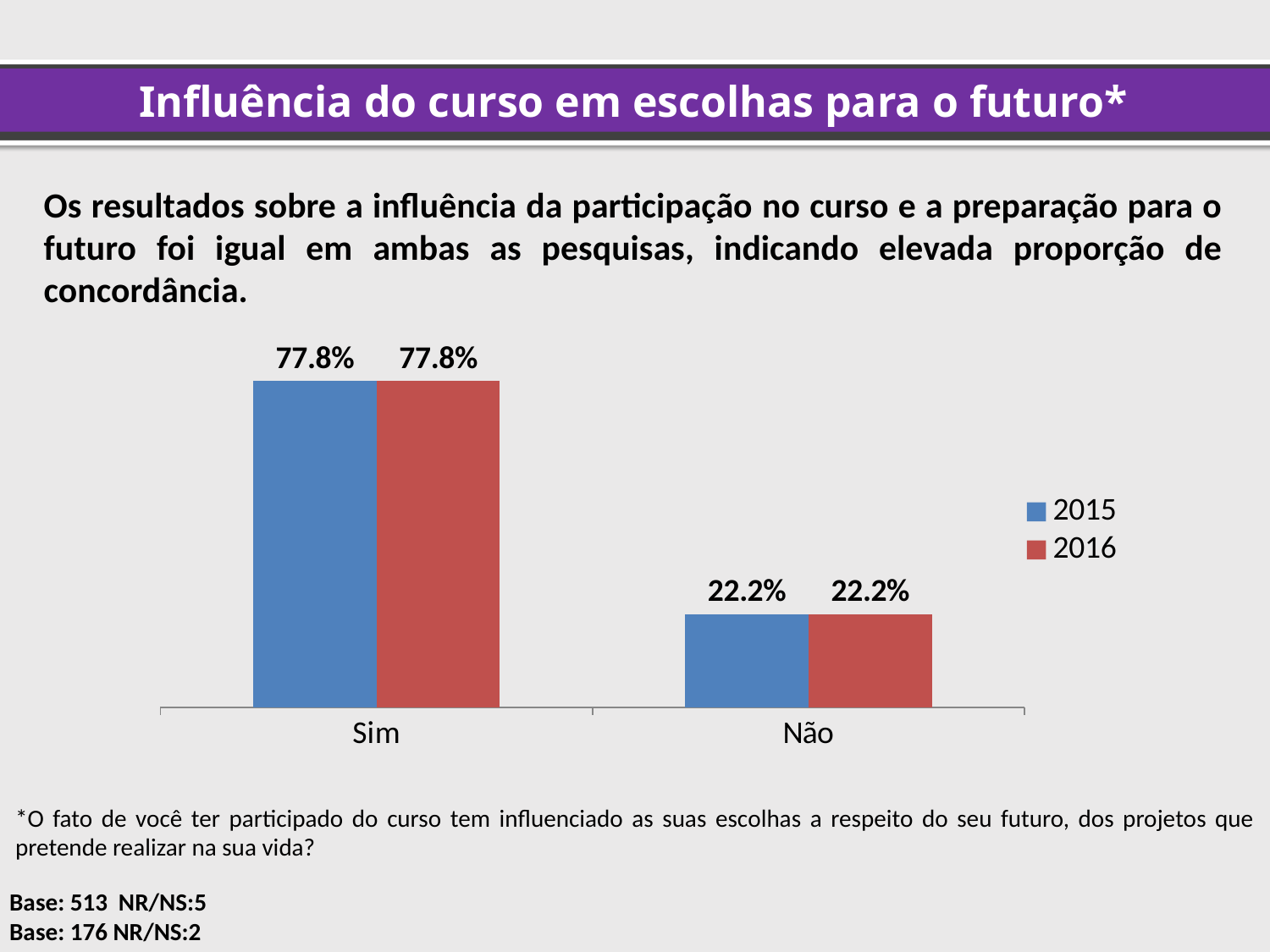
Which series is shown in red in the legend? 2016 Which category has the lowest value in the 2016 series? Não Which category has the highest value in the 2015 series? Sim Which is larger in the 2016 series: 'Sim' or 'Não'? Sim What kind of chart is shown on the slide? Bar chart How many categories are shown on the x axis? 2 What is the value for 'Sim' in the 2015 series? 77.8% What is the difference between the 'Sim' and 'Não' values in the 2015 series? 55.6% What is the value for 'Não' in the 2015 series? 22.2% What is the value for 'Sim' in the 2016 series? 77.8% What is the value for 'Não' in the 2016 series? 22.2% How many series does the legend list? 2